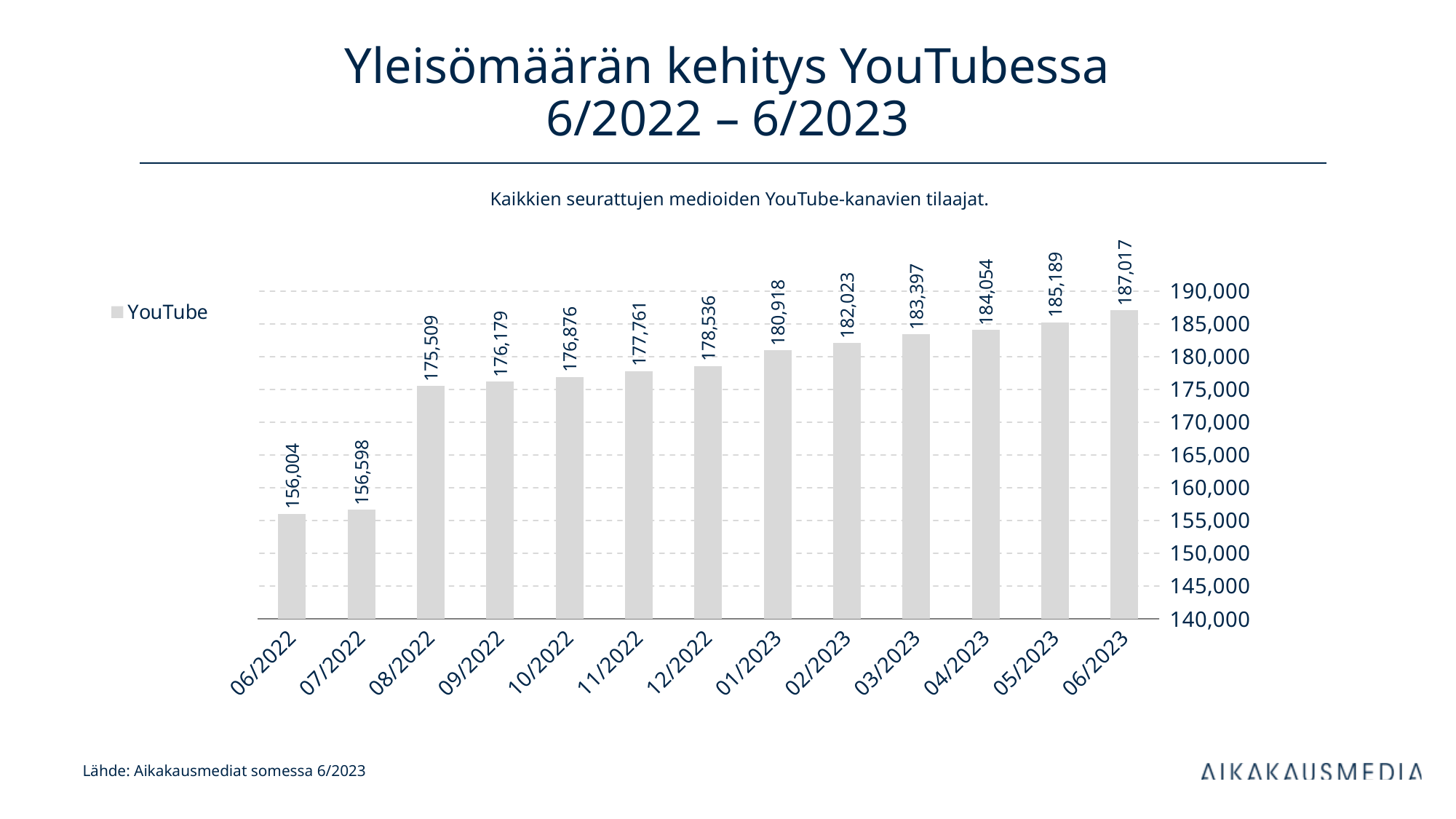
Which month has the highest value? 06/2023 What is the value for 06/2023? 187,017 Which month has the lowest value? 06/2022 Which is larger, the value for 12/2022 or the value for 10/2022? 12/2022 What is the value for 06/2022? 156,004 What is the value for 01/2023? 180,918 What is the difference between the values for 06/2023 and 06/2022? 31,013 What is the difference between the values for 08/2022 and 07/2022? 18,911 What kind of chart is shown on the slide? bar chart How many months are shown on the x axis? 13 Do the values rise or fall from 06/2022 to 06/2023? rise Is the value for 03/2023 greater or less than 180,000? greater